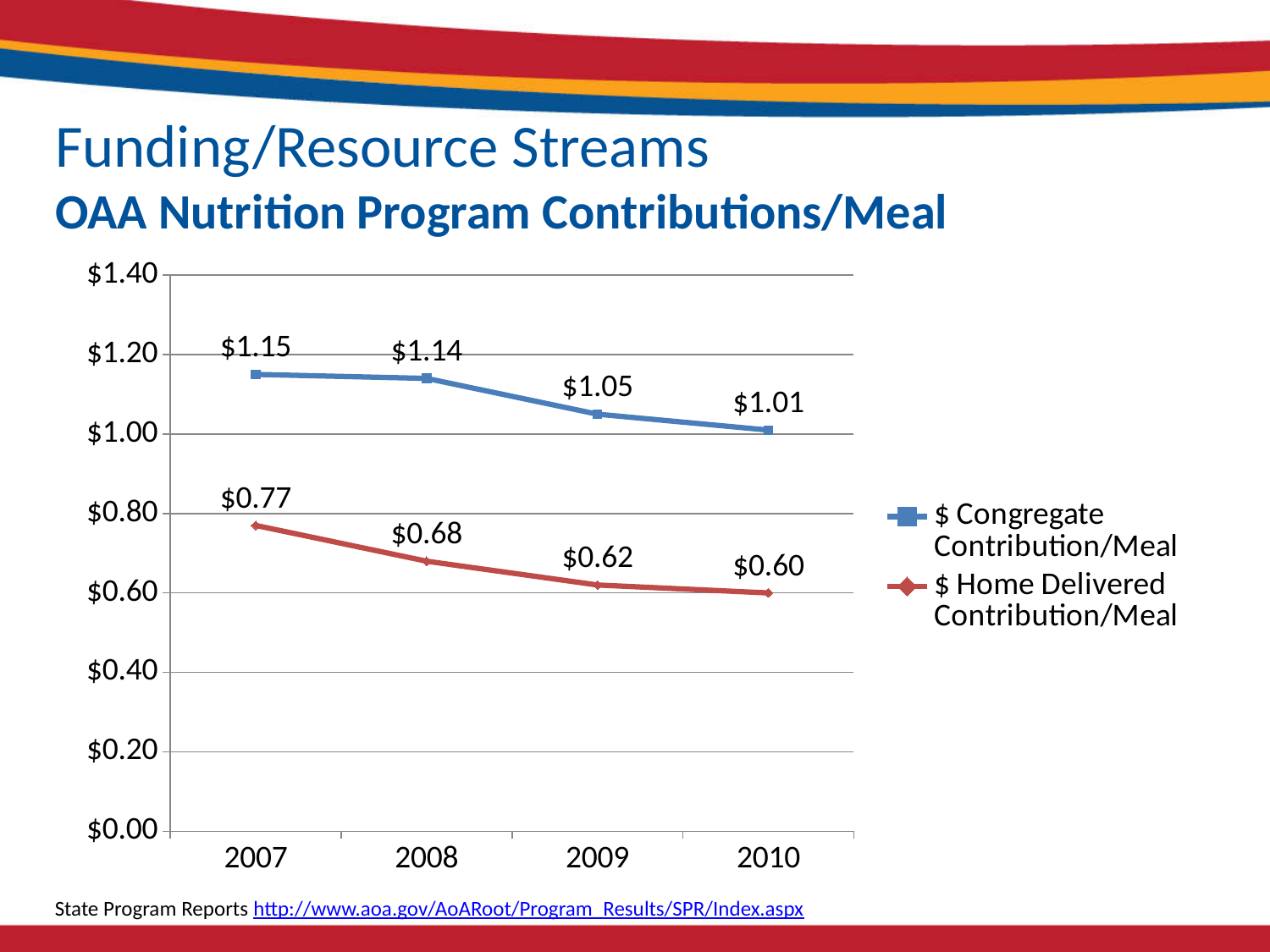
How many series does the legend list? 2 Does the $ Home Delivered Contribution/Meal rise or fall from 2007 to 2010? Fall What is the difference between the $ Congregate Contribution/Meal and the $ Home Delivered Contribution/Meal in 2009? $0.43 Which is larger in 2008: the $ Congregate Contribution/Meal or the $ Home Delivered Contribution/Meal? $ Congregate Contribution/Meal What is the $ Congregate Contribution/Meal value for 2007? $1.15 What is the $ Home Delivered Contribution/Meal value for 2010? $0.60 What kind of chart is shown on the slide? Line chart By how much did the $ Congregate Contribution/Meal fall from 2007 to 2010? $0.14 In which year is the $ Congregate Contribution/Meal highest? 2007 How many years are plotted on the x axis? 4 What is the $ Home Delivered Contribution/Meal value for 2008? $0.68 In which year is the $ Home Delivered Contribution/Meal lowest? 2010